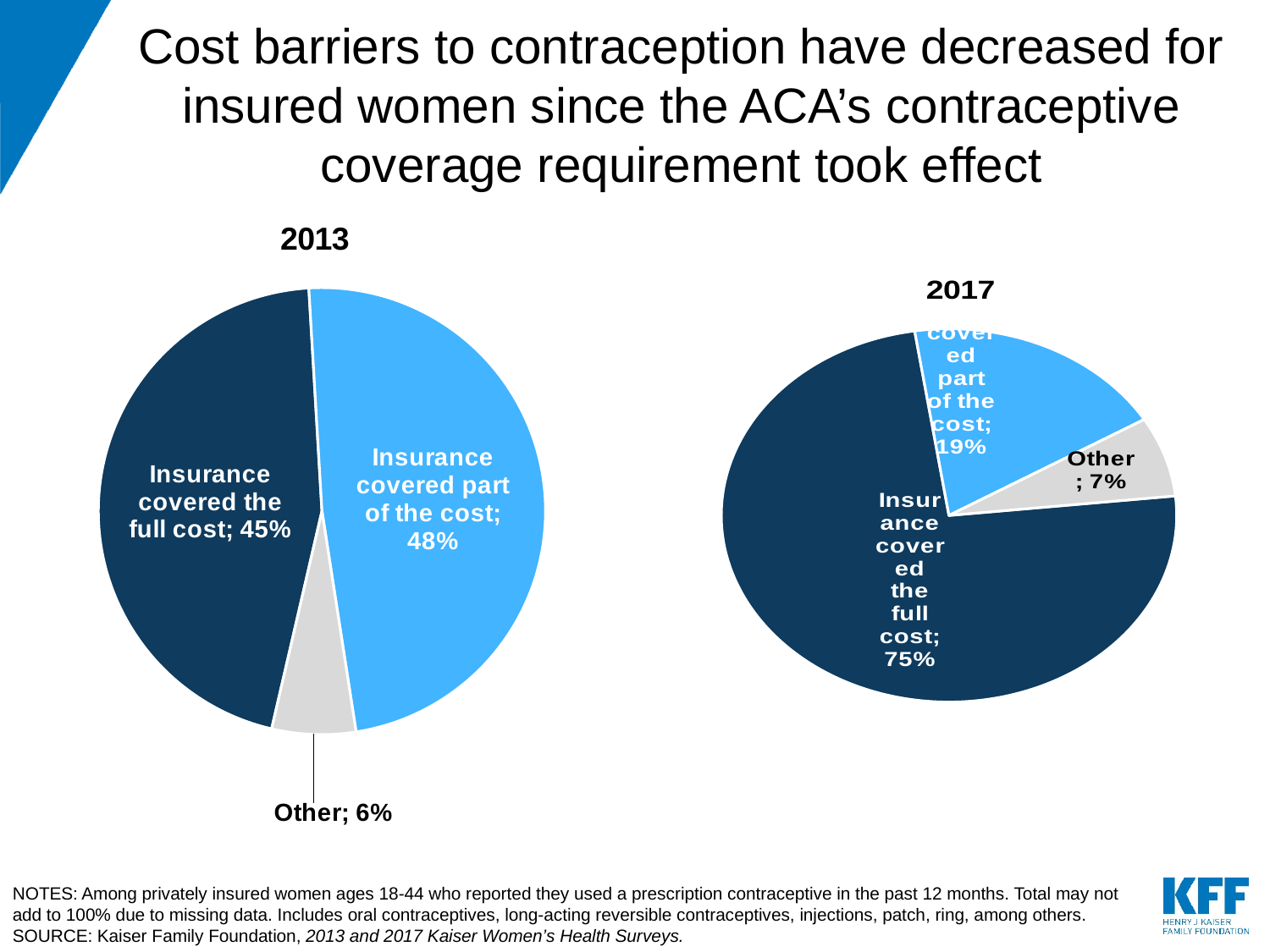
In the 2017 pie chart, what is the value for Other? 7% In the 2013 pie chart, what share of women reported that insurance covered part of the cost? 48% In the 2017 pie chart, what share of women reported that insurance covered the full cost? 75% How many slices does the 2017 pie chart have? 3 In the 2017 pie chart, what share of women reported that insurance covered part of the cost? 19% In the 2013 pie chart, which is larger: 'Insurance covered the full cost' or 'Insurance covered part of the cost'? Insurance covered part of the cost What type of chart is used for the 2013 data? Pie chart In the 2013 pie chart, what share of women reported that insurance covered the full cost? 45% In the 2013 pie chart, which category has the smallest slice? Other What is the difference between the share for 'Insurance covered the full cost' in 2017 and in 2013? 30 percentage points In the 2017 pie chart, which category has the largest slice? Insurance covered the full cost In the 2013 pie chart, what is the value for Other? 6%